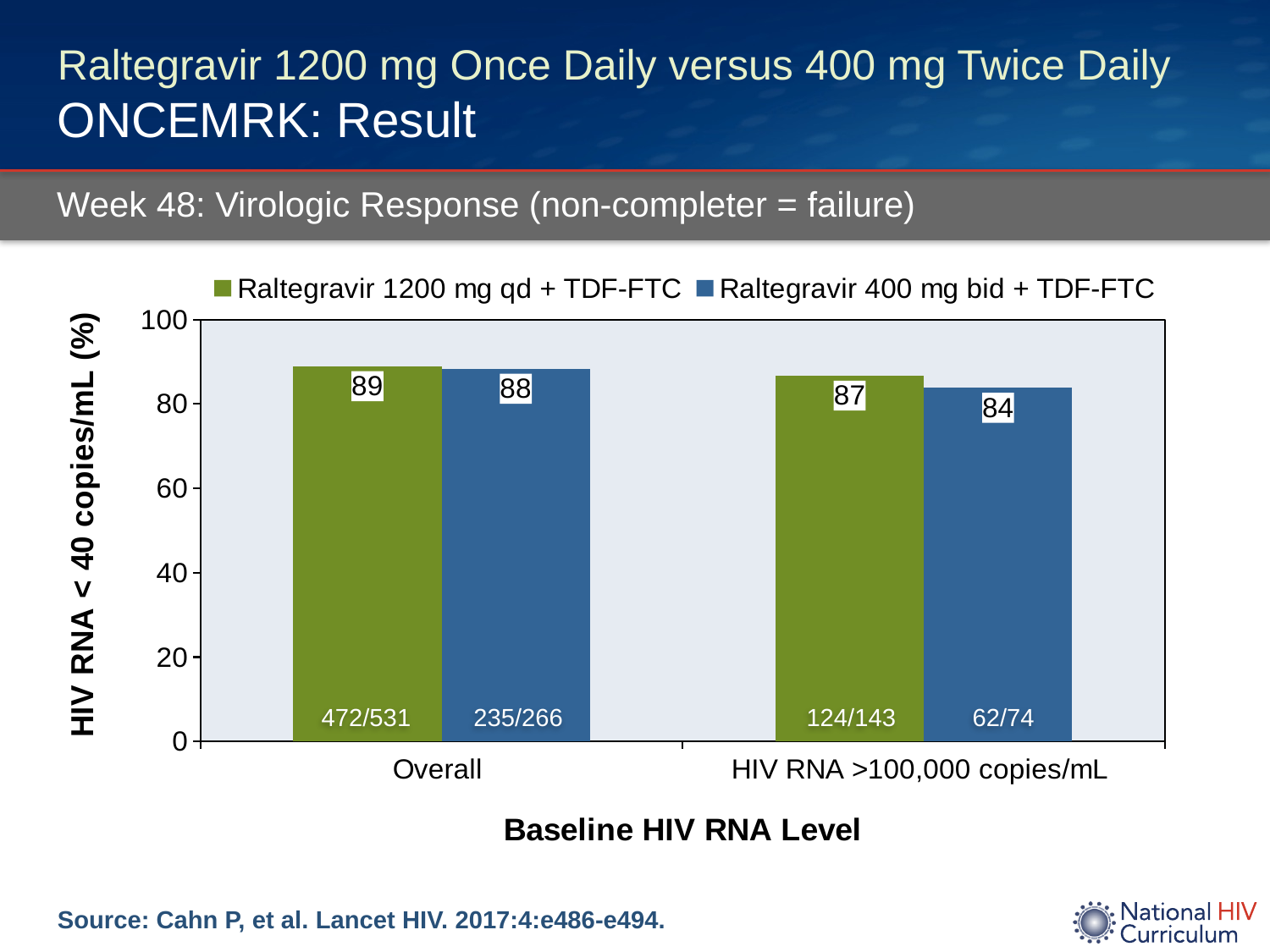
What is the value for Raltegravir 1200 mg qd + TDF-FTC in the Overall category? 89 How many categories are shown on the x axis? 2 What is the value for Raltegravir 400 mg bid + TDF-FTC in the HIV RNA >100,000 copies/mL category? 84 Which bar has the lowest value on the chart? Raltegravir 400 mg bid + TDF-FTC, HIV RNA >100,000 copies/mL What fraction is printed on the Raltegravir 1200 mg qd + TDF-FTC bar for HIV RNA >100,000 copies/mL? 124/143 What is the difference between the Raltegravir 1200 mg qd + TDF-FTC values for Overall and HIV RNA >100,000 copies/mL? 2 Which series has the higher value in the HIV RNA >100,000 copies/mL category? Raltegravir 1200 mg qd + TDF-FTC Is the value for Raltegravir 400 mg bid + TDF-FTC in the Overall category greater or less than 80? greater What is the difference between the two series in the HIV RNA >100,000 copies/mL category? 3 What is the value for Raltegravir 400 mg bid + TDF-FTC in the Overall category? 88 What kind of chart is shown on the slide? Bar chart How many series does the legend list? 2